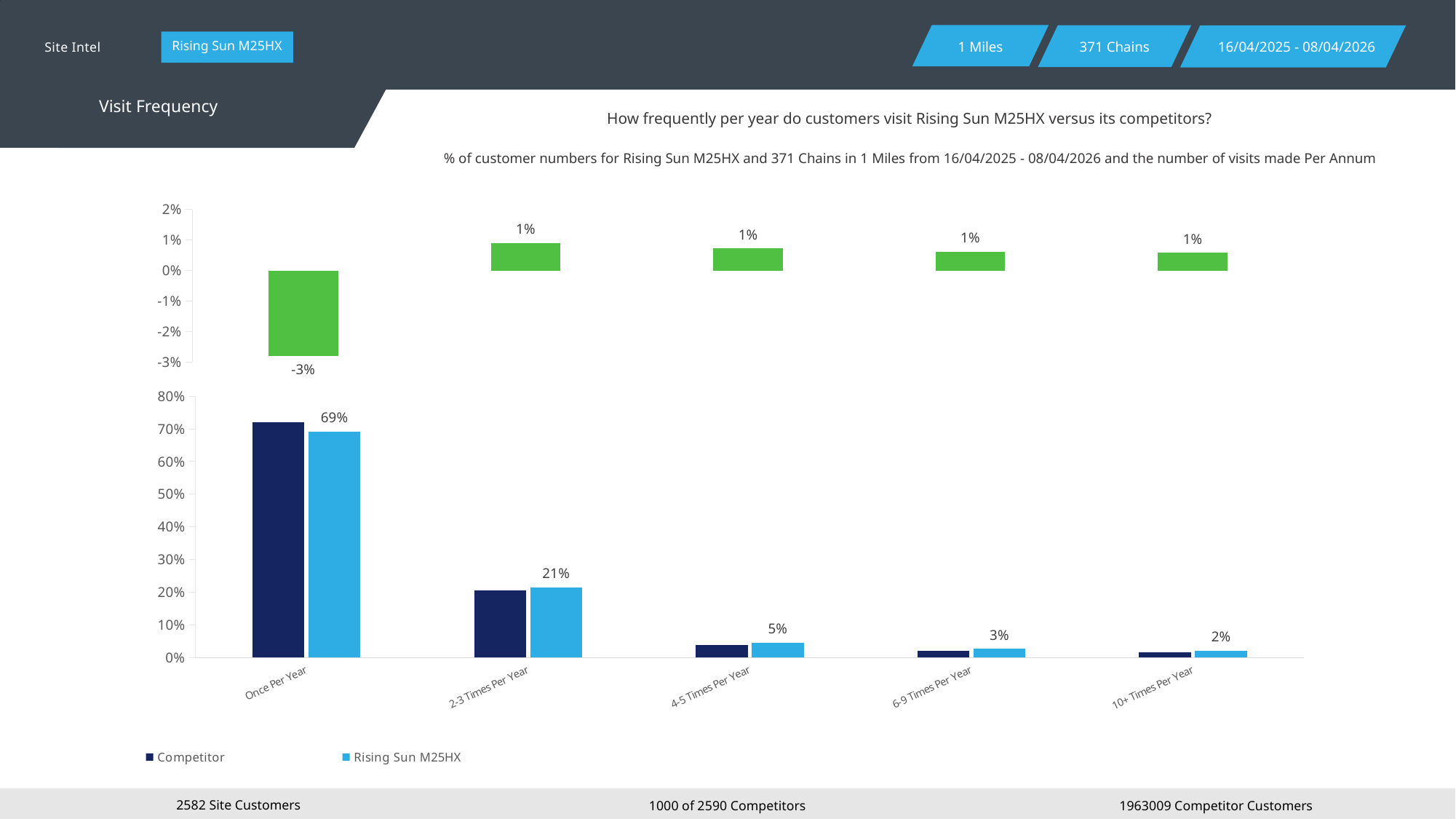
In the bottom chart, which category has the highest value for Rising Sun M25HX? Once Per Year In the bottom chart, what is the value for Rising Sun M25HX in the 2-3 Times Per Year category? 21% How many series does the legend of the bottom chart list? 2 What kind of chart is the bottom chart? Bar chart In the top chart, which category has the lowest value? Once Per Year In the bottom chart, which category has the lowest value for Rising Sun M25HX? 10+ Times Per Year How many categories are shown on the x axis of the bottom chart? 5 In the bottom chart, is the Competitor value for 2-3 Times Per Year greater or less than 30%? less In the bottom chart, what is the difference between the Rising Sun M25HX values for Once Per Year and 2-3 Times Per Year? 48% In the top chart, what is the value shown for the Once Per Year category? -3% In the bottom chart, what is the value for Rising Sun M25HX in the Once Per Year category? 69% In the bottom chart, for the Once Per Year category, which series has the larger value: Competitor or Rising Sun M25HX? Competitor